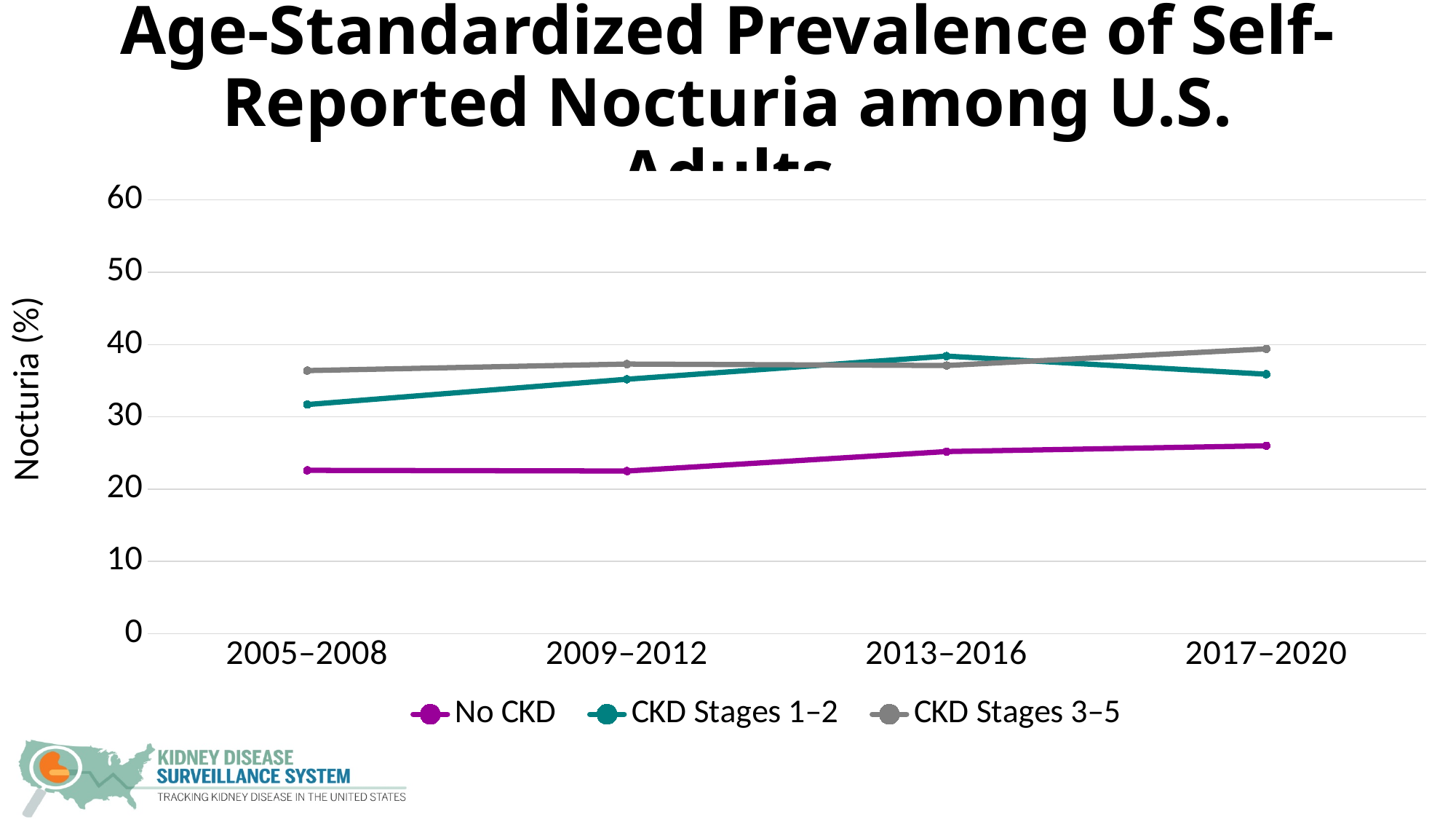
Which series has the highest value in 2005–2008? CKD Stages 3–5 What is the label of the y axis? Nocturia (%) What kind of chart is shown on the slide? line chart Is the value for No CKD in 2005–2008 greater or less than 30? less Is the value for CKD Stages 1–2 in 2013–2016 greater or less than 30? greater How many series does the legend list? 3 Is the value for No CKD in 2017–2020 greater or less than 20? greater Does the No CKD line rise or fall from 2005–2008 to 2017–2020? rise Which series has the lowest values across all periods? No CKD How many time periods are shown on the x axis? 4 In 2005–2008, which is larger: CKD Stages 1–2 or CKD Stages 3–5? CKD Stages 3–5